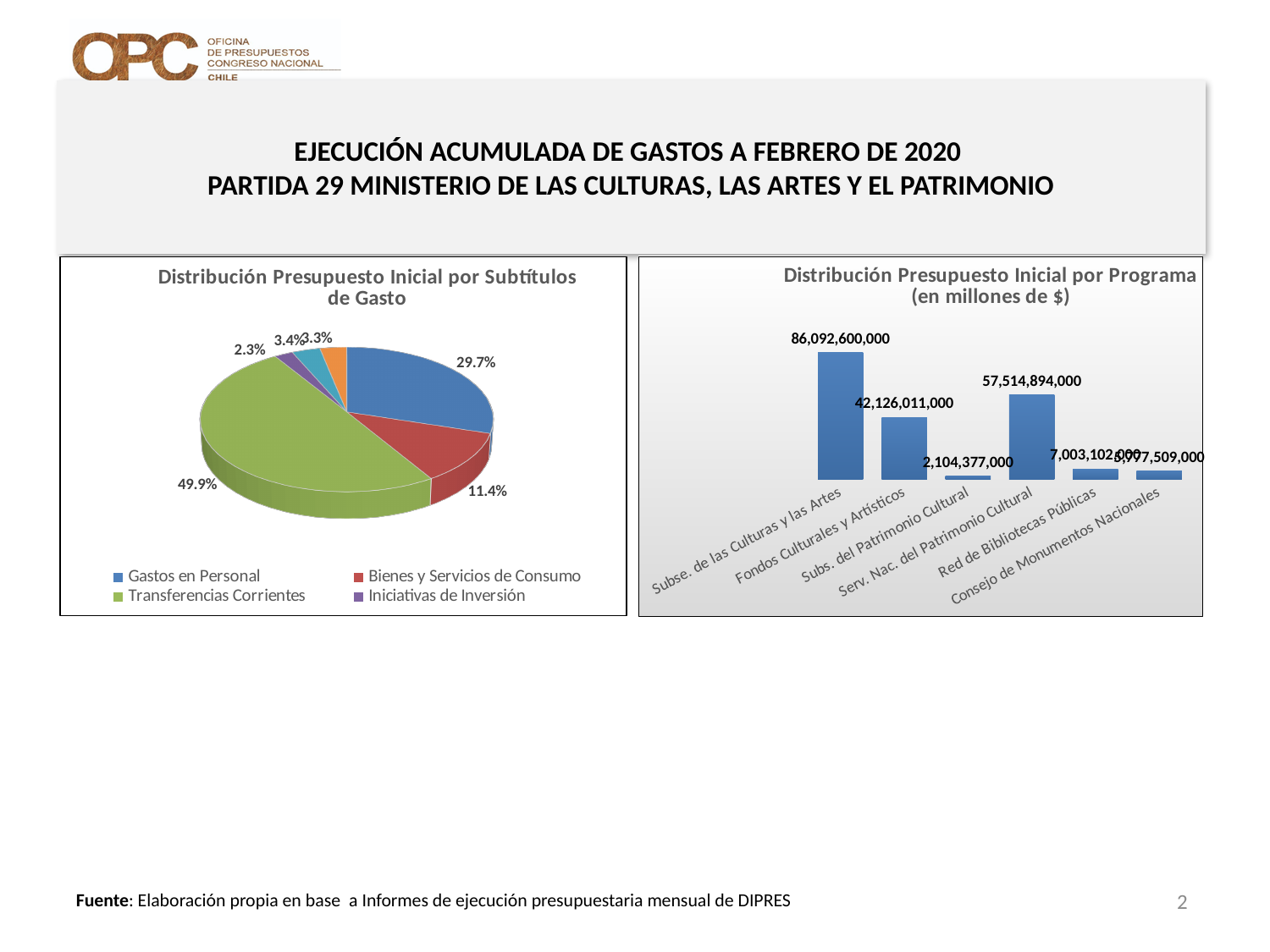
In the chart 'Distribución Presupuesto Inicial por Programa', how many programs are shown? 6 In the chart 'Distribución Presupuesto Inicial por Programa', what is the difference between Subse. de las Culturas y las Artes and Serv. Nac. del Patrimonio Cultural? 28,577,706,000 In the chart 'Distribución Presupuesto Inicial por Subtítulos de Gasto', how many percentage points larger is Transferencias Corrientes than Gastos en Personal? 20.2 percentage points In the chart 'Distribución Presupuesto Inicial por Programa', what is the value for Serv. Nac. del Patrimonio Cultural? 57,514,894,000 In the chart 'Distribución Presupuesto Inicial por Subtítulos de Gasto', what share of the pie does Transferencias Corrientes represent? 49.9% In the chart 'Distribución Presupuesto Inicial por Subtítulos de Gasto', which category has the largest slice? Transferencias Corrientes In the chart 'Distribución Presupuesto Inicial por Programa', which program has the lowest value? Subs. del Patrimonio Cultural In the chart 'Distribución Presupuesto Inicial por Programa', what is the value for Subse. de las Culturas y las Artes? 86,092,600,000 What kind of chart is 'Distribución Presupuesto Inicial por Subtítulos de Gasto'? Pie chart In the chart 'Distribución Presupuesto Inicial por Subtítulos de Gasto', how many entries does the legend list? 4 In the chart 'Distribución Presupuesto Inicial por Subtítulos de Gasto', what percentage is shown for Gastos en Personal? 29.7% In the chart 'Distribución Presupuesto Inicial por Subtítulos de Gasto', what percentage is shown for Bienes y Servicios de Consumo? 11.4%